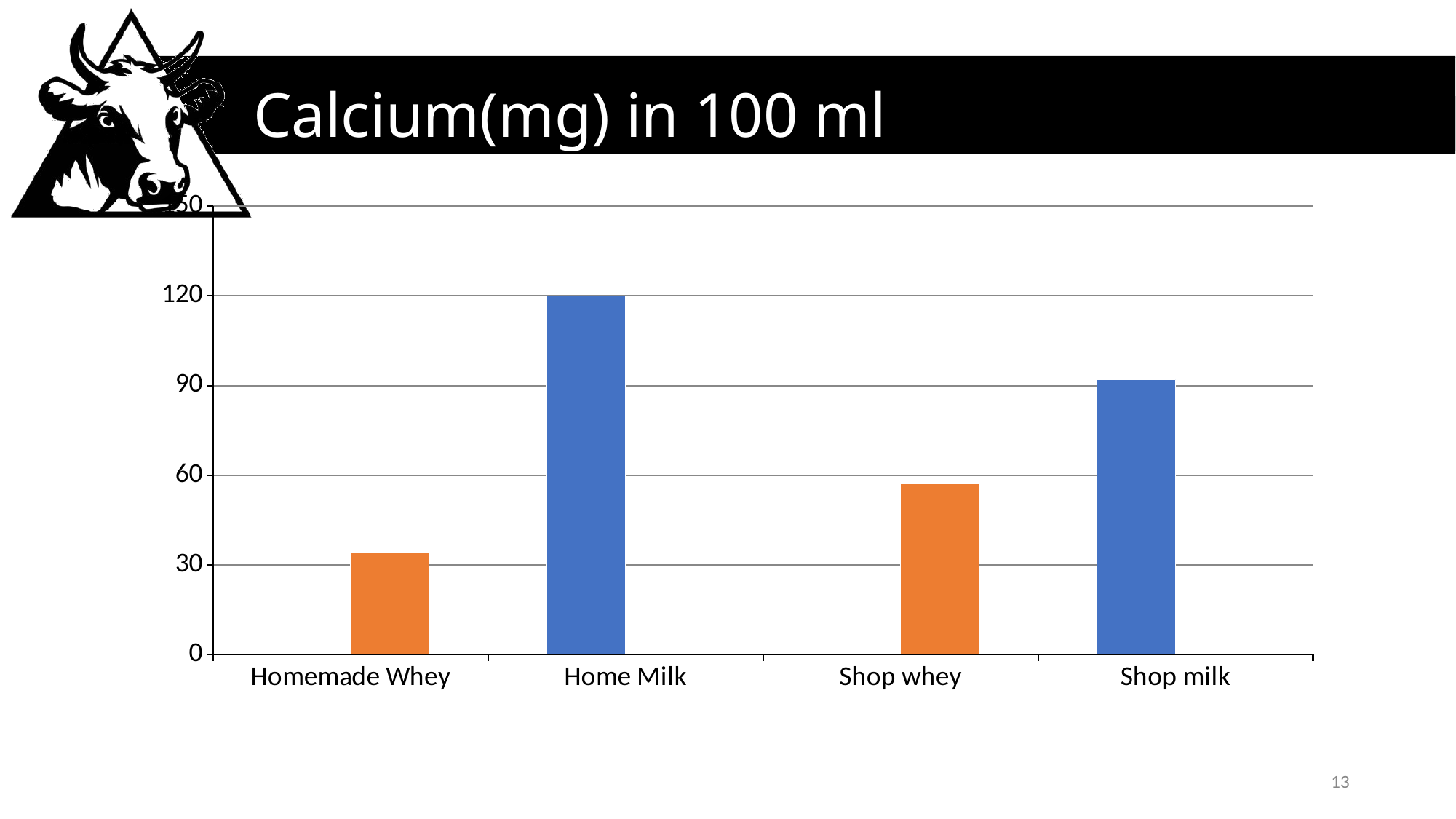
Which category has the lowest calcium value? Homemade Whey Is the value for Shop whey greater or less than 60? less What colour are the bars for the whey categories? orange What is the calcium value for Home Milk? 120 Which category has the highest calcium value? Home Milk What is the title of the chart? Calcium(mg) in 100 ml Is the value for Homemade Whey greater or less than 60? less Which is larger, the value for Home Milk or the value for Shop milk? Home Milk Which is larger, the value for Shop whey or the value for Homemade Whey? Shop whey How many categories are shown on the x axis? 4 What kind of chart is shown on the slide? bar chart